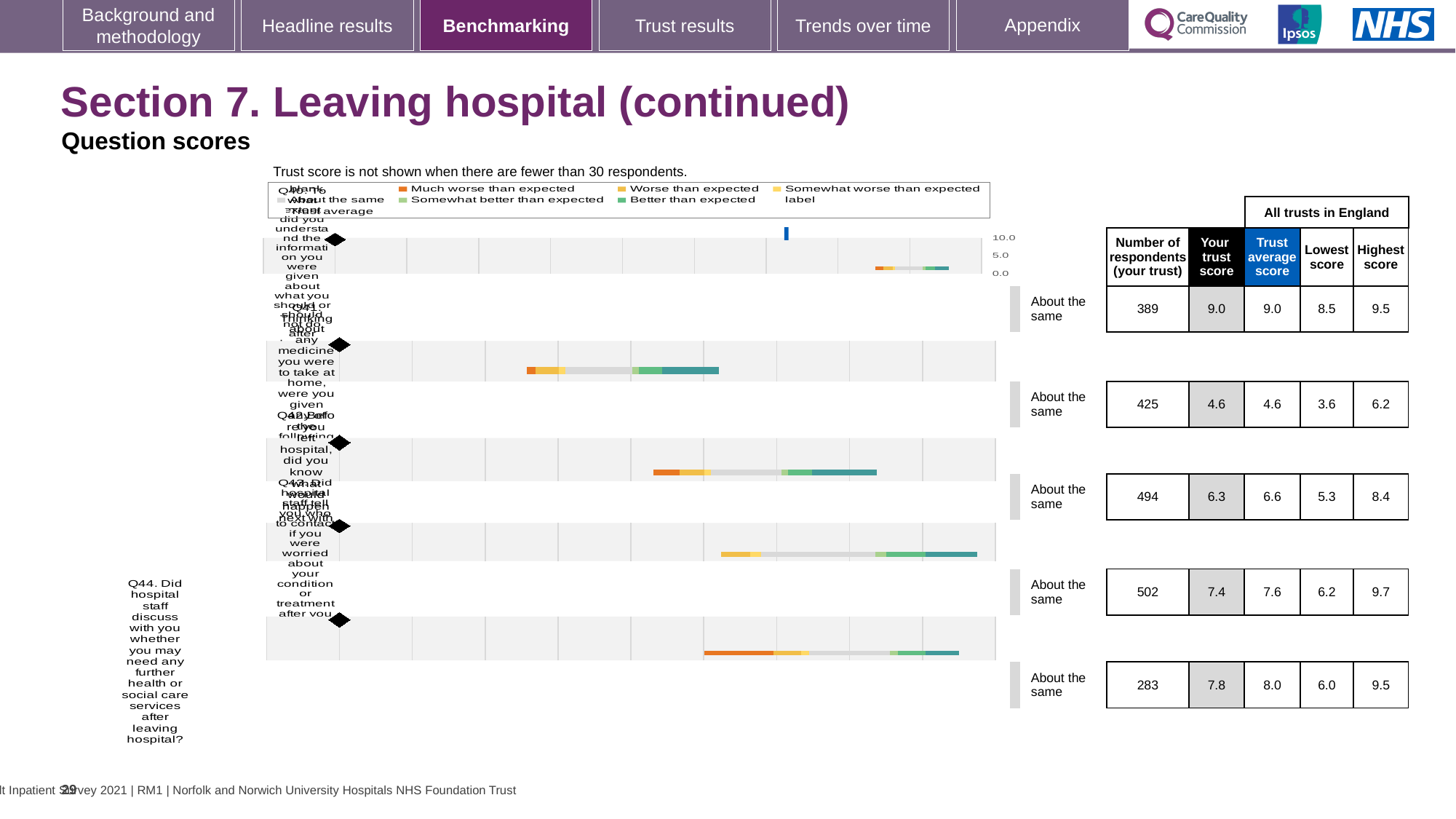
What comparison label is shown next to the chart for Q44? About the same What is the 'Your trust score' value for Q44 (Did hospital staff discuss with you whether you may need any further health or social care services after leaving hospital?)? 7.8 What is the 'Highest score' across all trusts in England for Q44? 9.5 How many questions (rows) are shown in the benchmarking chart on this slide? 5 What kind of chart is used to show the question scores on this slide? Bar chart How many respondents (your trust) are shown for Q44? 283 What is the 'Lowest score' across all trusts in England for Q44? 6.0 What is the highest 'Your trust score' value among the five questions shown? 9.0 What is the difference between the highest score and the lowest score for Q44? 3.5 What is the lowest 'Your trust score' value among the five questions shown? 4.6 For Q44, which is larger: the 'Your trust score' or the 'Trust average score'? Trust average score What is the 'Trust average score' for Q44? 8.0